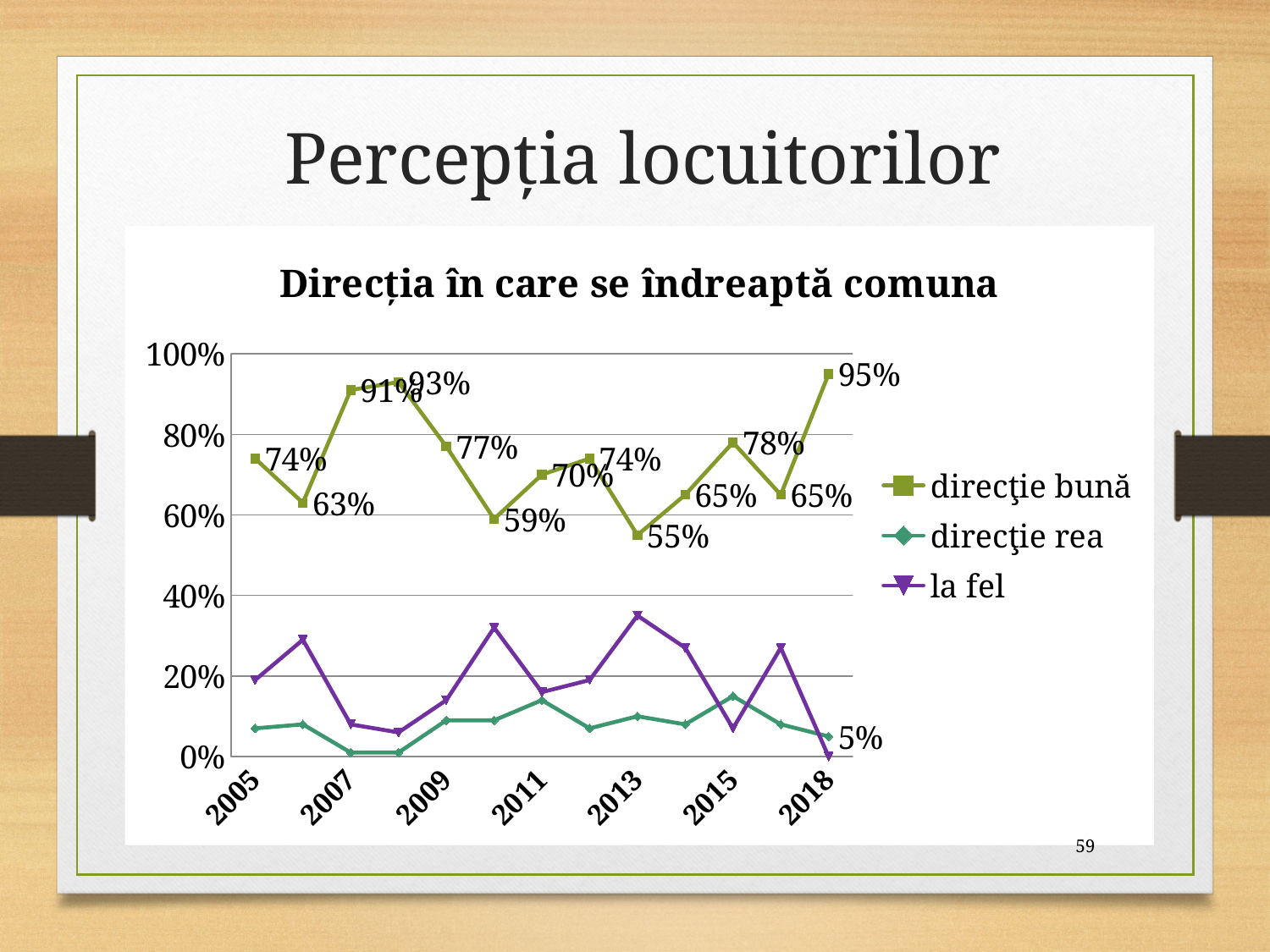
What type of chart is shown on the slide? line chart In which year is 'direcţie bună' highest? 2018 What is the value for 'direcţie bună' in 2018? 95% What is the difference between the 'direcţie bună' values in 2018 and 2005? 21 percentage points What is the value for 'direcţie bună' in 2005? 74% Which is larger for 'direcţie bună': the value in 2007 or the value in 2009? 2007 How many series does the legend list? 3 What is the value for 'direcţie bună' in 2013? 55% In which year is 'direcţie bună' lowest? 2013 What is the title of the chart? Direcția în care se îndreaptă comuna Is the value for 'la fel' in 2013 greater or less than 20%? greater What is the value for 'direcţie rea' in 2018? 5%